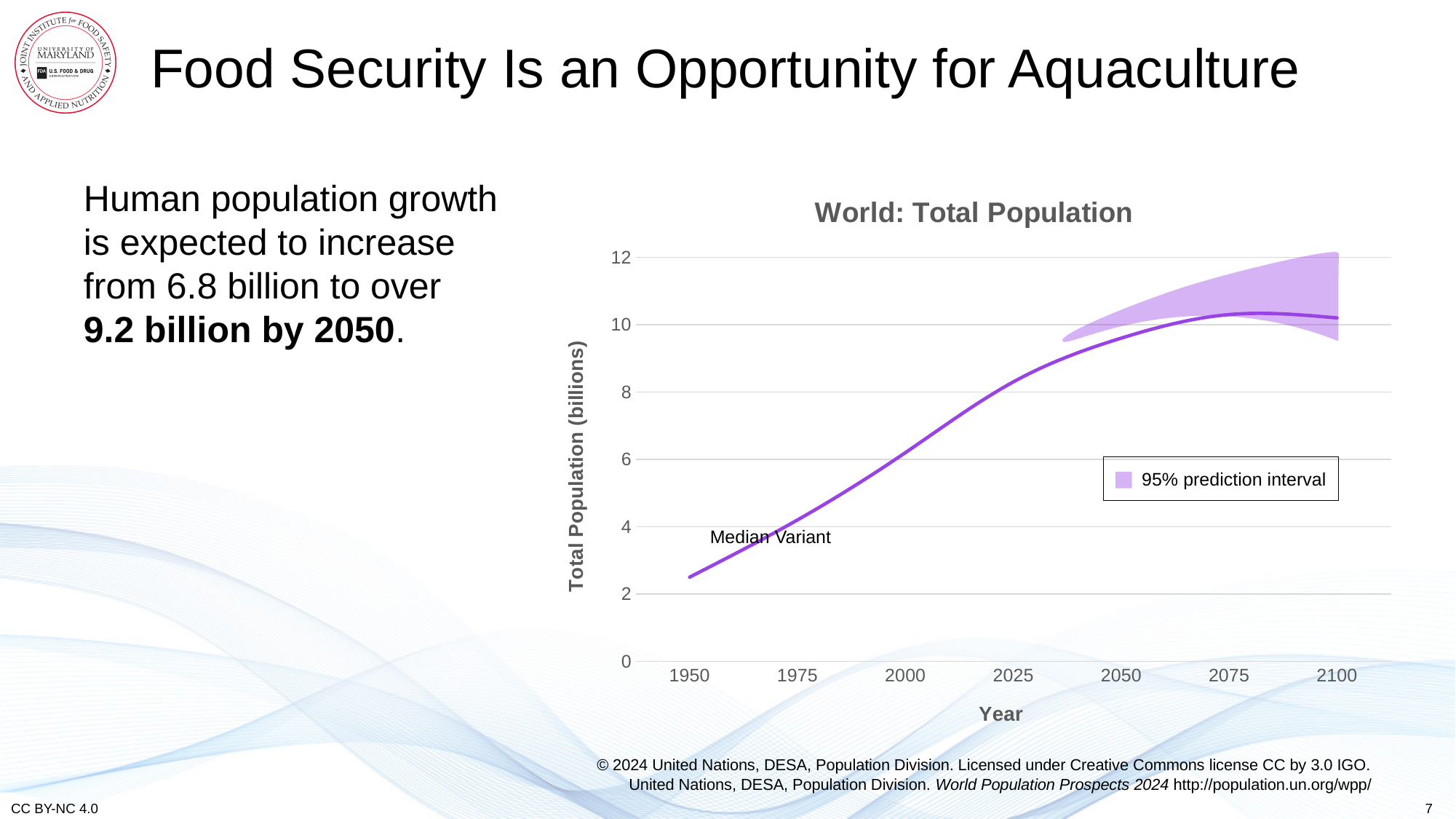
What is the title of the chart? World: Total Population Is the median variant value for 2050 greater or less than 8? greater Which year shown on the x axis has the lowest median variant value? 1950 Is the median variant value for 2100 greater or less than 12? less Which is larger, the median variant value for 2000 or for 1950? 2000 Is the median variant value for 2025 greater or less than 10? less Does the median variant line rise or fall between 1950 and 2050? rise What does the shaded area in the chart represent, according to the legend? 95% prediction interval What is the label of the y axis of the chart? Total Population (billions) What kind of chart is shown on the slide? line chart